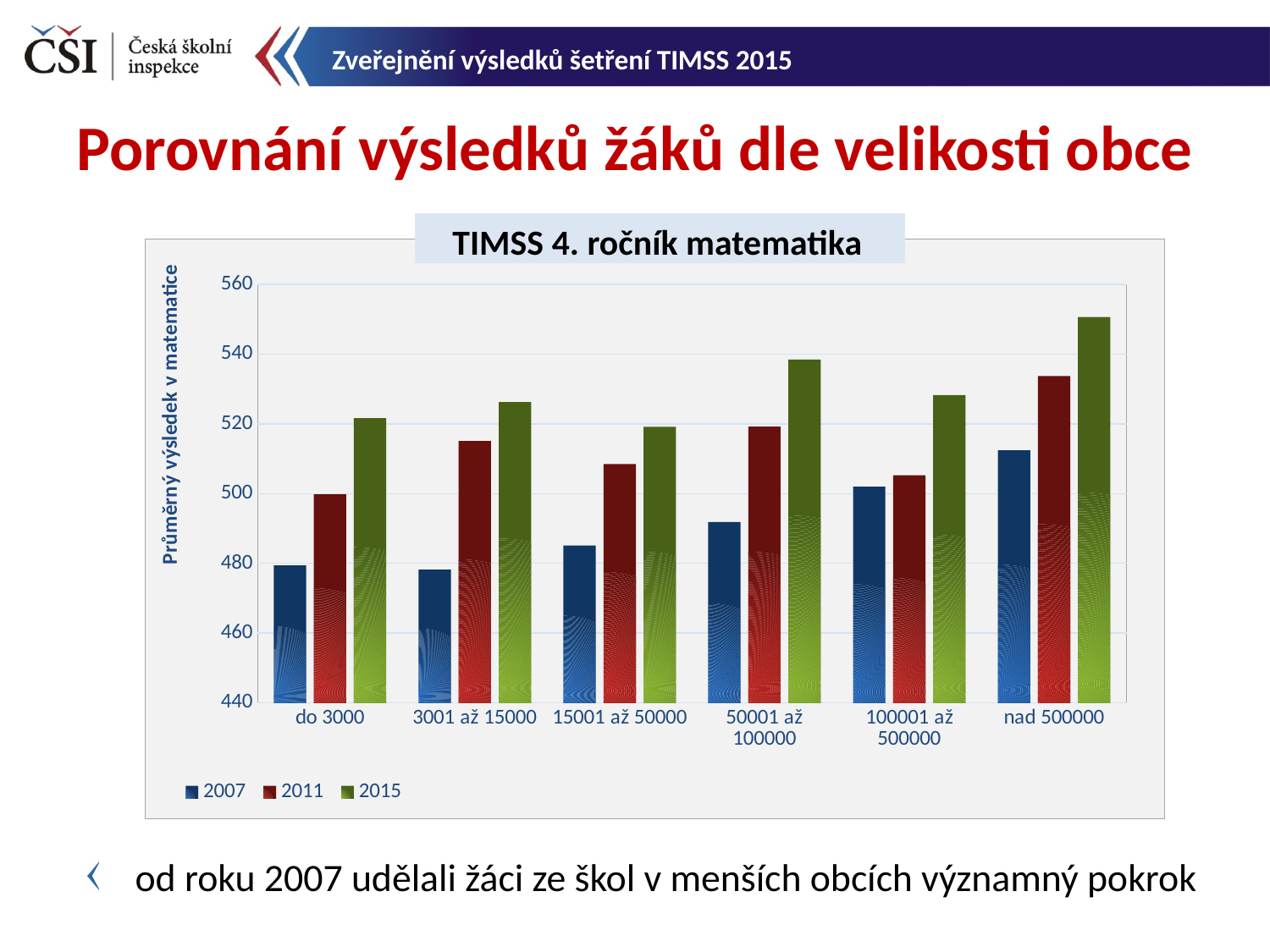
Which is larger: the 2007 value for nad 500000 or the 2007 value for do 3000? nad 500000 Is the 2011 value for 3001 až 15000 greater or less than 500? greater What is the title of the chart? TIMSS 4. ročník matematika Is the 2015 value for nad 500000 greater or less than 540? greater Which category has the highest value for the 2007 series? nad 500000 Which category has the highest value for the 2015 series? nad 500000 For the category do 3000, do the values rise or fall from 2007 to 2015? rise How many municipality-size categories are shown on the x axis? 6 For the category 50001 až 100000, which is larger: the 2011 value or the 2015 value? 2015 What kind of chart is shown on the slide? bar chart How many series does the legend list? 3 Is the 2007 value for do 3000 greater or less than 500? less